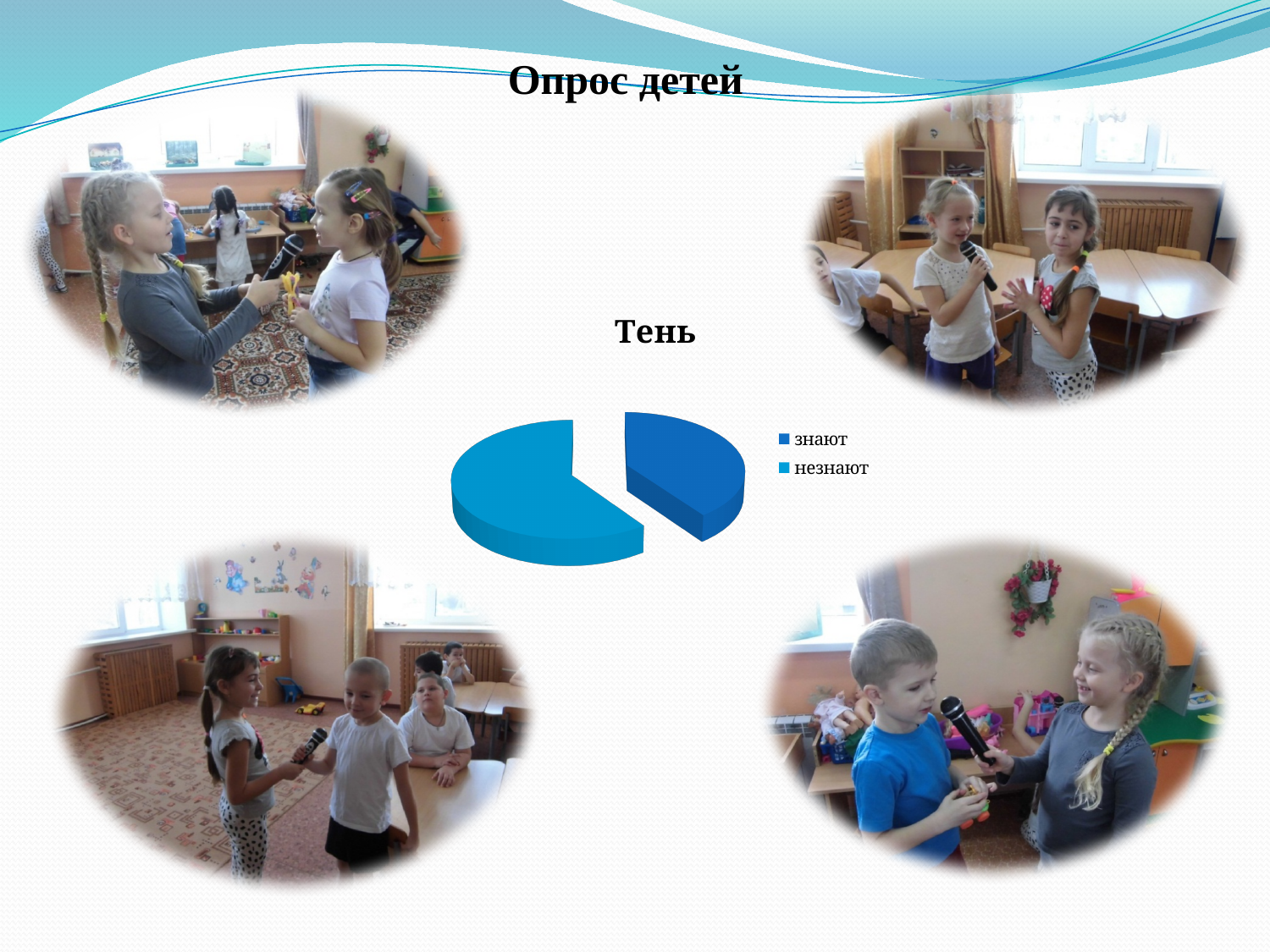
What kind of chart is shown on the slide? pie chart Which legend entry is listed first in the pie chart's legend? знают Which category has the largest slice in the pie chart? незнают Which category has the smallest slice in the pie chart? знают How many entries does the legend of the pie chart list? 2 What is the title of the pie chart? Тень How many slices does the pie chart have? 2 Which slice is larger in the pie chart, знают or незнают? незнают